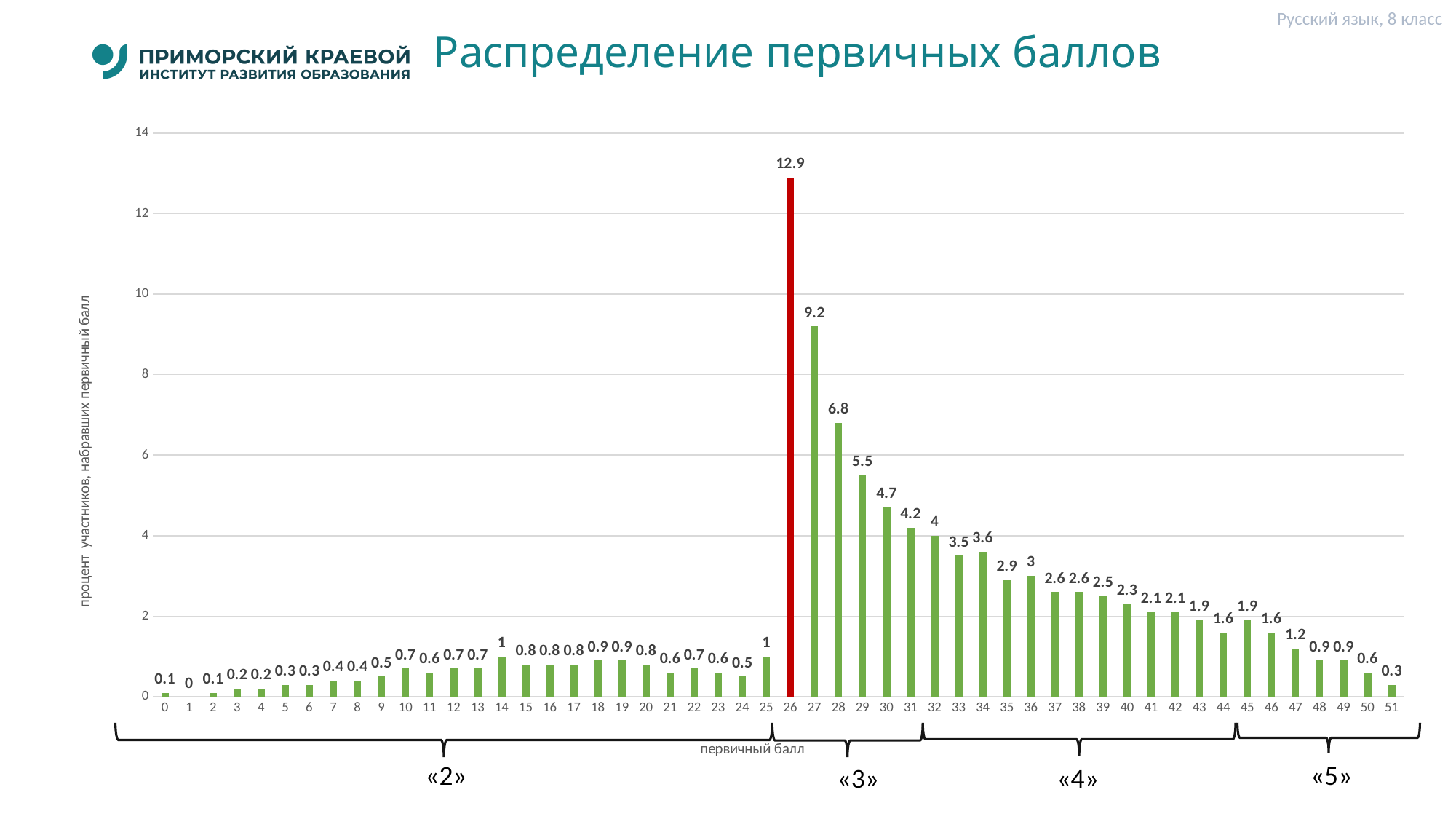
Which primary score has the highest percentage of participants? 26 What is the title of the chart? Распределение первичных баллов What is the value for primary score 51? 0.3 Is the value for primary score 28 greater or less than 6? greater What is the value for primary score 36? 3 What is the value for primary score 26? 12.9 What type of chart is shown on the slide? bar chart Which primary score has the lowest percentage of participants? 1 Which is larger, the value for primary score 33 or primary score 34? 34 How many primary score categories are shown on the x axis? 52 What is the value for primary score 27? 9.2 What is the difference between the values for primary scores 26 and 27? 3.7